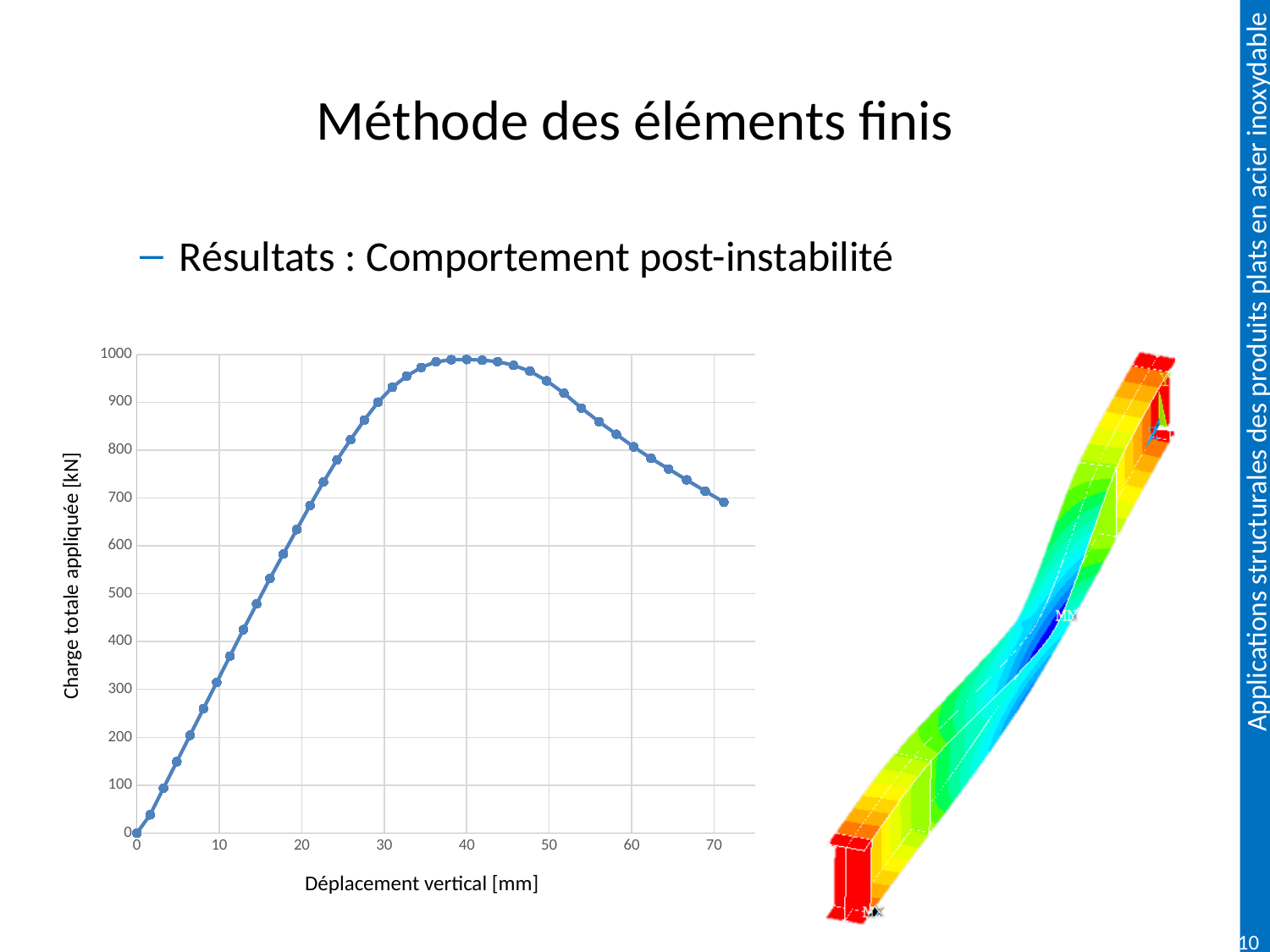
What is the applied load at a vertical displacement of 0 mm? 0 Is the peak applied load greater or less than 1000 kN? less What is the label of the y axis of the chart? Charge totale appliquée [kN] What is the label of the x axis of the chart? Déplacement vertical [mm] Is the applied load at a vertical displacement of 20 mm greater or less than 600 kN? greater What kind of chart is shown on the slide? line chart Is the applied load at a vertical displacement of 70 mm greater or less than 800 kN? less Does the applied load rise or fall as the vertical displacement increases from 0 mm to 30 mm? rise Which is larger, the applied load at 20 mm or at 60 mm of vertical displacement? 60 mm Does the applied load rise or fall as the vertical displacement increases from 50 mm to 70 mm? fall